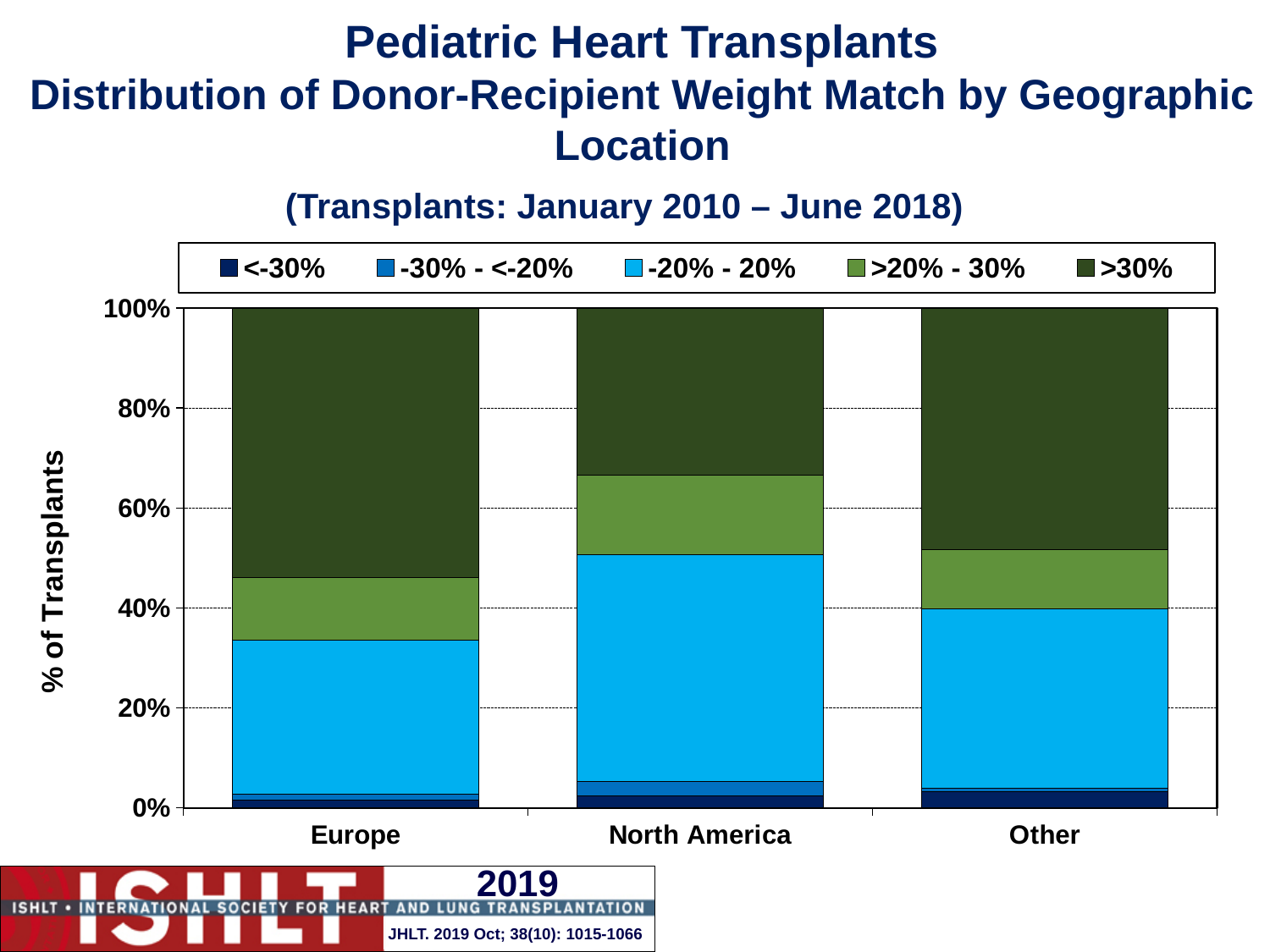
Is the -20% - 20% share for North America greater or less than 40%? greater How many geographic locations are shown on the x axis? 3 Is the >30% share for Europe larger or smaller than the >30% share for North America? Larger What is the label of the y axis? % of Transplants Is the >30% share for North America greater or less than 40%? less Which geographic location has the largest share of transplants in the -20% - 20% weight-match category? North America Which geographic location has the largest share of transplants in the >30% weight-match category? Europe Is the >30% share for Europe greater or less than 40%? greater What kind of chart is shown on the slide? Stacked bar chart How many series does the legend list? 5 Is the -20% - 20% share for North America larger or smaller than the -20% - 20% share for Europe? Larger What time period of transplants does the chart cover? January 2010 – June 2018